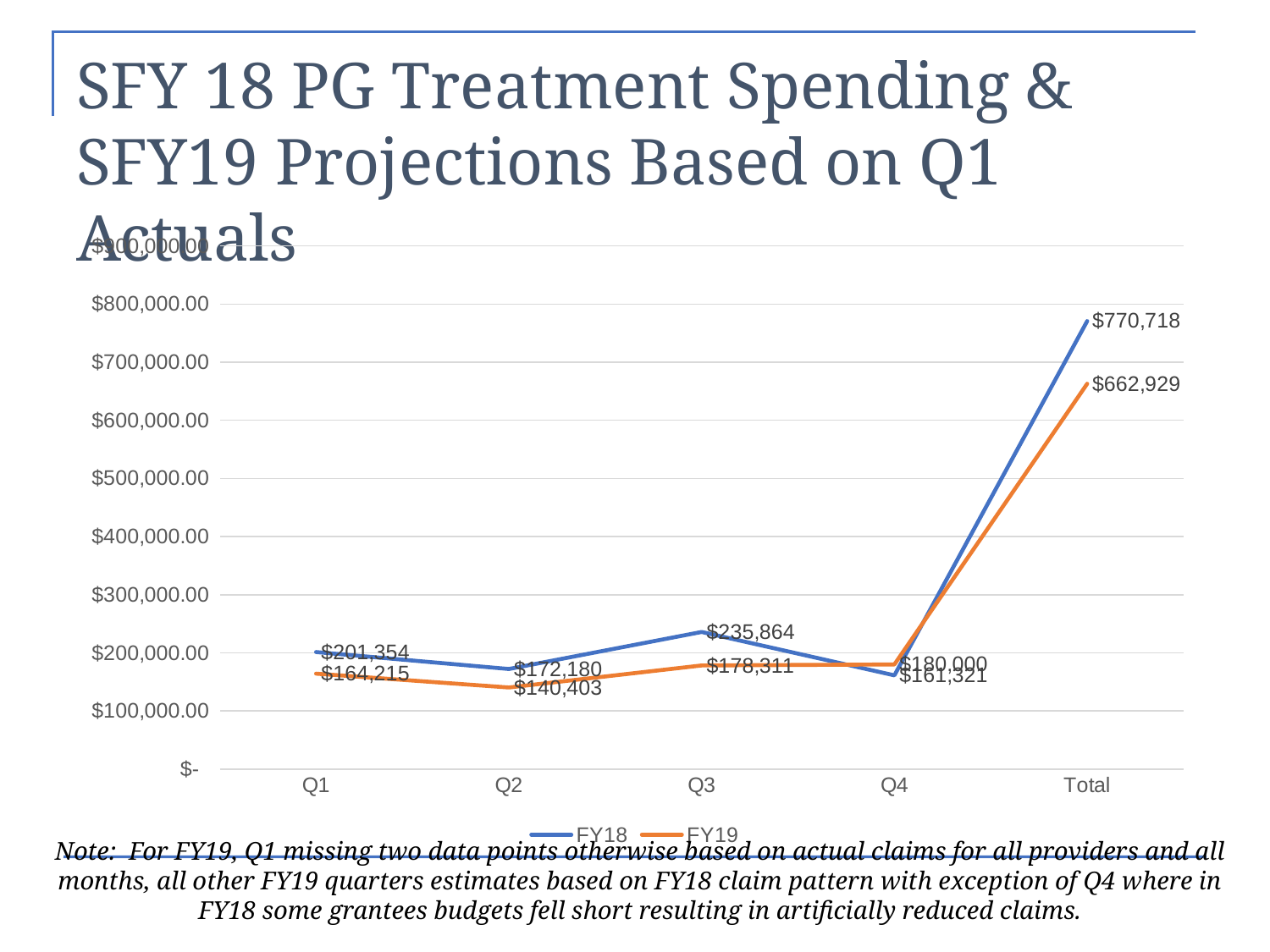
Which is larger at Q4, the FY18 value or the FY19 value? FY19 Which series is drawn in orange? FY19 What is the difference between the FY18 Total and the FY19 Total? $107,789 How many series does the legend list? 2 How many categories are shown on the x axis? 5 Among the quarters Q1 to Q4, which quarter has the lowest FY19 value? Q2 What type of chart is shown on the slide? line chart What is the FY18 Total value? $770,718 What is the FY18 value for Q3? $235,864 What is the FY19 Total value? $662,929 What is the FY19 value for Q2? $140,403 Among the quarters Q1 to Q4, which quarter has the highest FY18 value? Q3